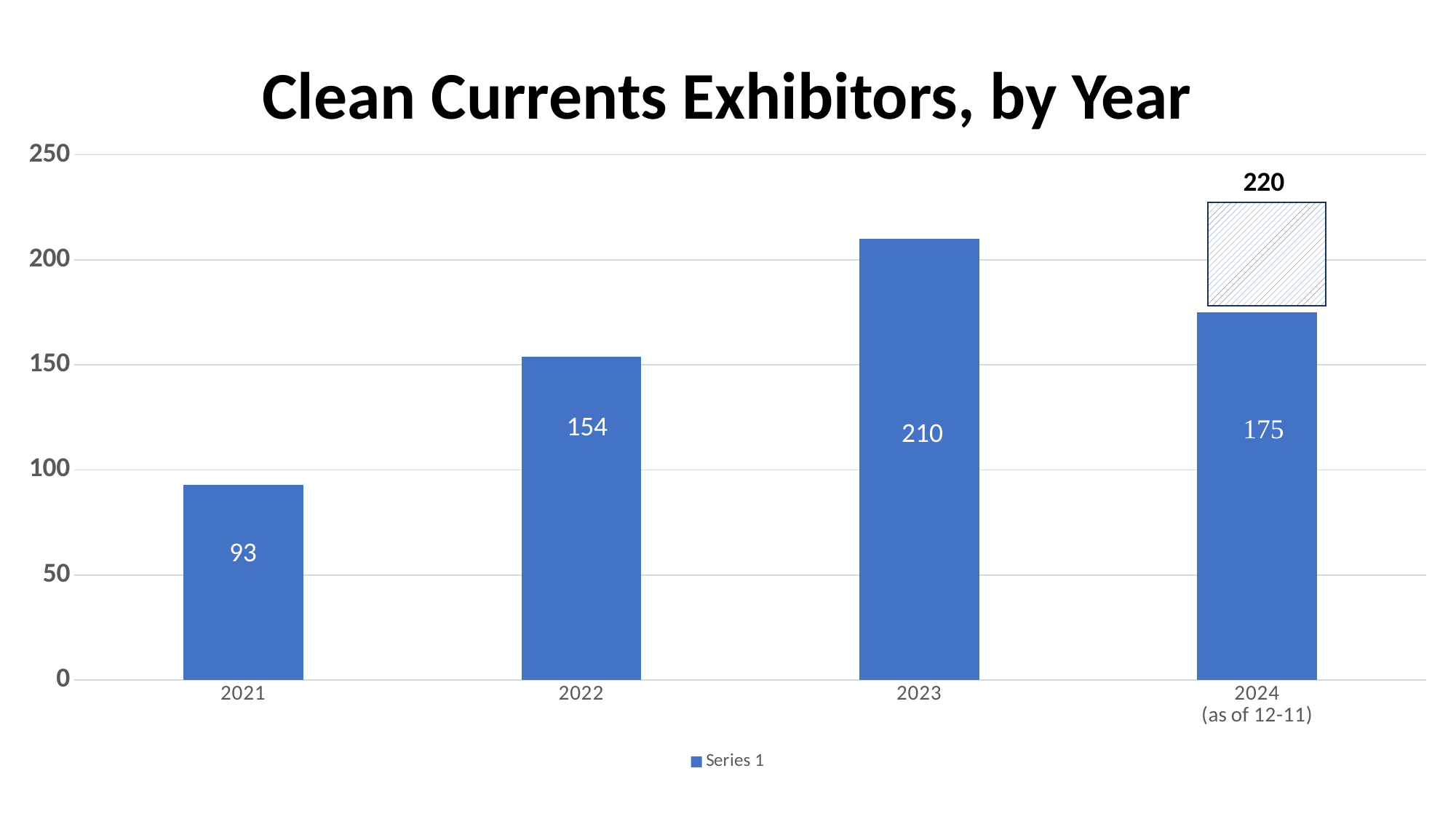
How many years are shown on the x axis? 4 What is the value for 2022? 154 Which year has the lowest value? 2021 What is the difference between the values for 2023 and 2022? 56 What is the value for 2021? 93 Which is larger, the value for 2023 or the solid bar value for 2024? 2023 What is the value for 2023? 210 What kind of chart is this? Bar chart What is the title of the chart? Clean Currents Exhibitors, by Year What is the value of the solid bar for 2024 (as of 12-11)? 175 What is the difference between the values for 2022 and 2021? 61 Which year has the highest solid bar? 2023